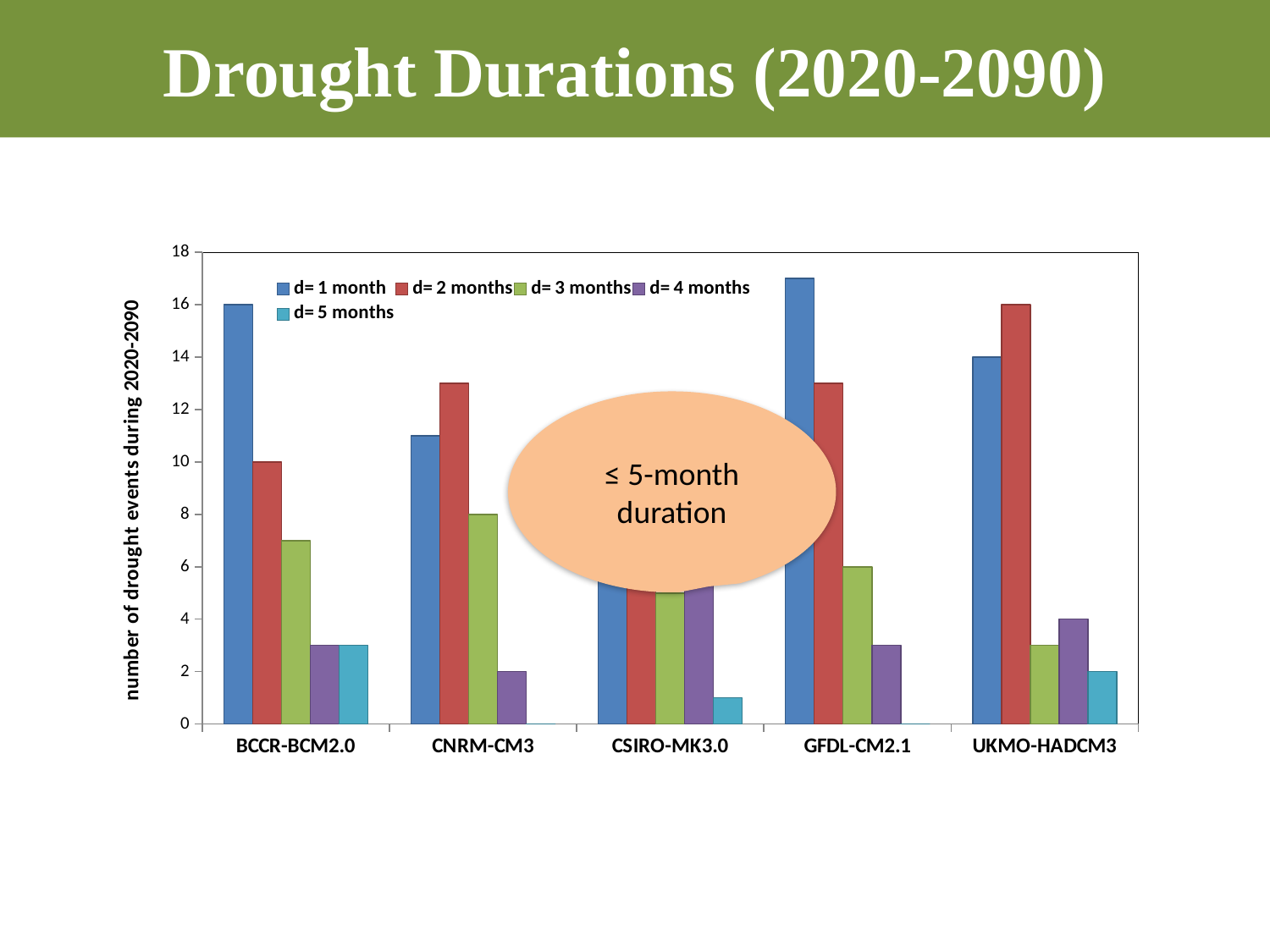
What is the label of the y axis? number of drought events during 2020-2090 What is the number of drought events for d= 1 month for BCCR-BCM2.0? 16 Is the value for d= 1 month for GFDL-CM2.1 greater or less than 16? greater What type of chart is shown on the slide? bar chart What is the number of drought events for d= 2 months for UKMO-HADCM3? 16 Is the value for d= 2 months for CNRM-CM3 greater or less than 12? greater What is the difference between the d= 1 month and d= 2 months values for BCCR-BCM2.0? 6 How many climate models (categories) are shown on the x axis? 5 Which model has the highest value for d= 2 months? UKMO-HADCM3 How many series does the legend list? 5 What is the number of drought events for d= 4 months for UKMO-HADCM3? 4 What is the number of drought events for d= 3 months for CNRM-CM3? 8